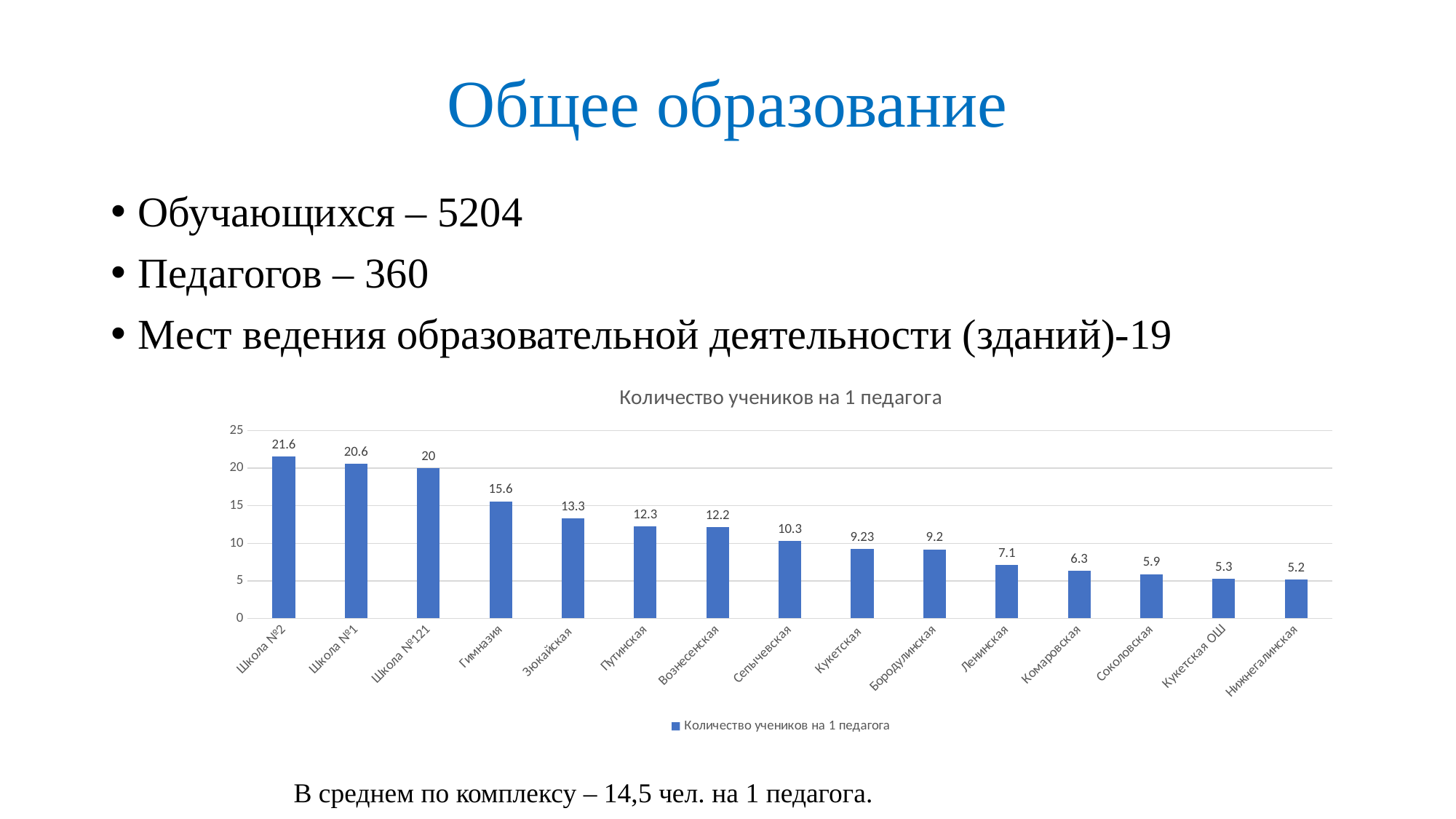
Which is larger, the value for Зюкайская or the value for Сепычевская? Зюкайская Is the value for Ленинская greater or less than 10? less What is the value for Гимназия? 15.6 What is the title of the chart? Количество учеников на 1 педагога What is the difference between the values for Школа №2 and Нижнегалинская? 16.4 Which category has the lowest value? Нижнегалинская Which category has the highest value? Школа №2 What is the value for Школа №2? 21.6 How many categories are shown on the x axis? 15 What kind of chart is shown? bar chart What is the value for Кукетская? 9.23 How many series does the legend list? 1